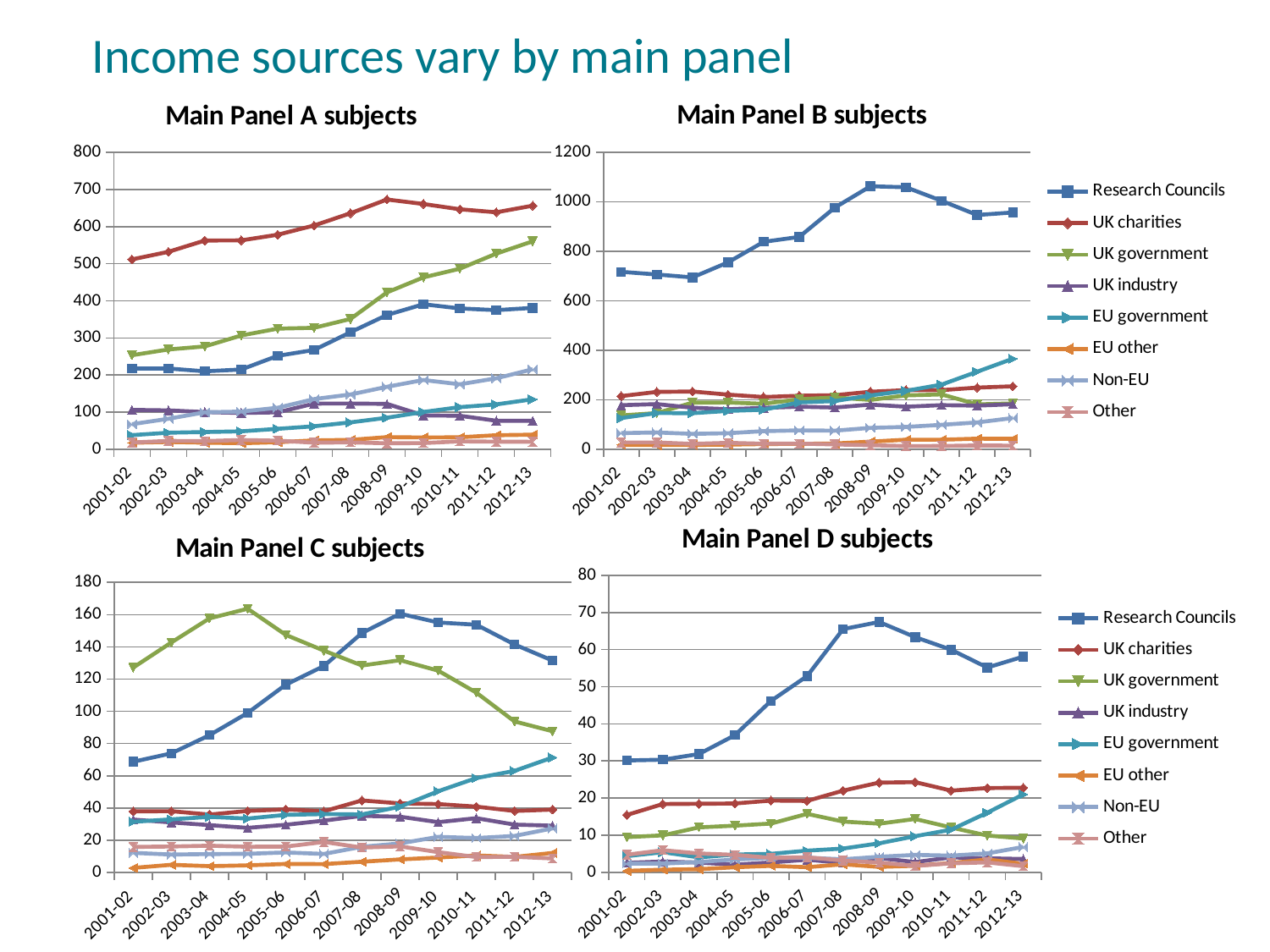
How many series does the legend next to the Main Panel B subjects chart list? 8 In the Main Panel B subjects chart, in which year does Research Councils reach its highest value? 2008-09 In the Main Panel A subjects chart, which series has the highest values across all years? UK charities In the Main Panel B subjects chart, is the value for Research Councils in 2001-02 greater or less than 800? less In the Main Panel A subjects chart, does the UK government series rise or fall from 2001-02 to 2012-13? rise In the Main Panel D subjects chart, is the value for Research Councils in 2008-09 greater or less than 60? greater In the Main Panel C subjects chart, which is larger in 2012-13: Research Councils or UK government? Research Councils What type of chart is used for the Main Panel A subjects chart? line chart In the Main Panel A subjects chart, is the value for Research Councils in 2012-13 greater or less than 400? less In the Main Panel C subjects chart, in which year does UK government reach its highest value? 2004-05 How many years are plotted along the x axis of the Main Panel C subjects chart? 12 What is the title of the slide? Income sources vary by main panel